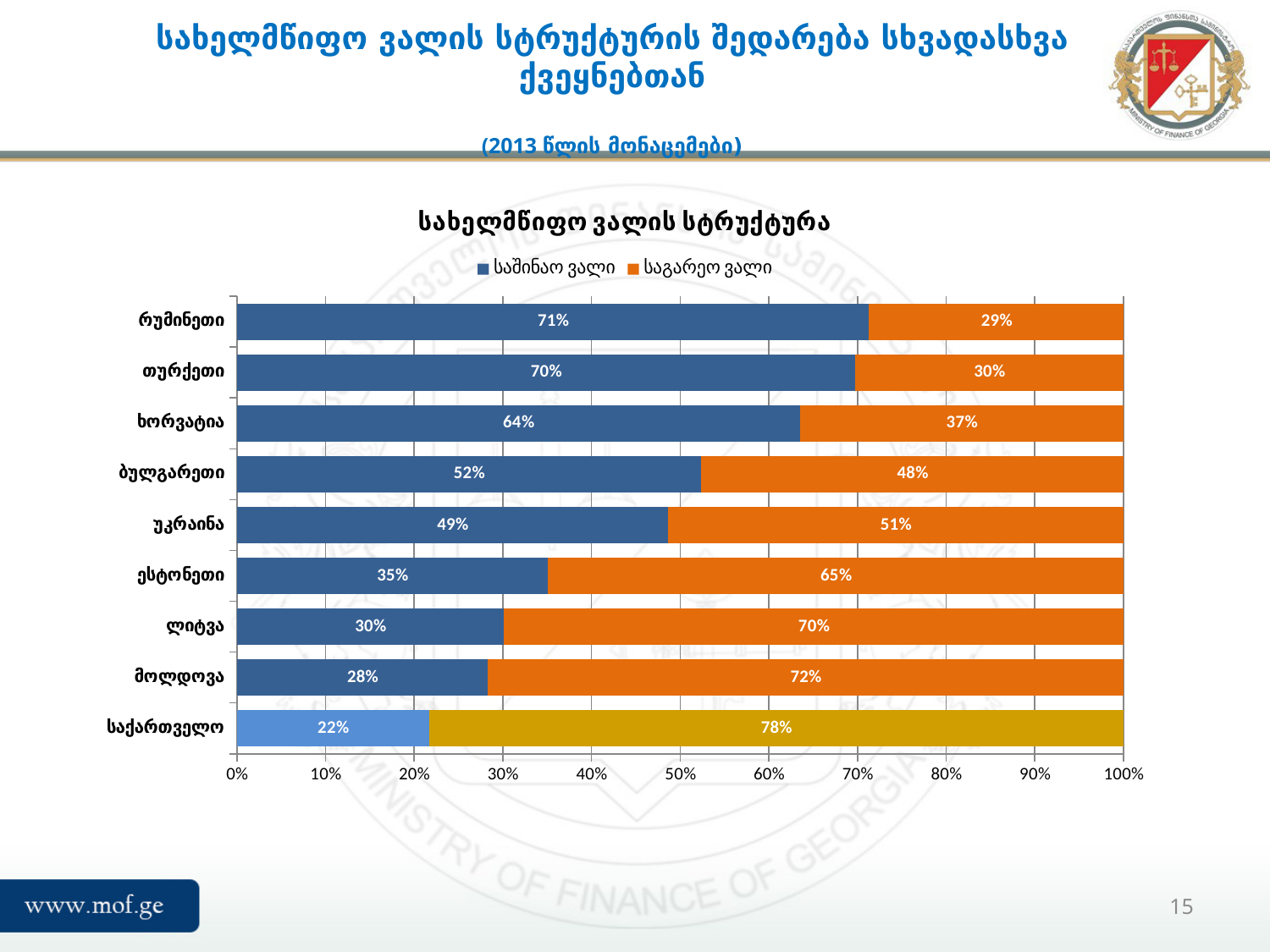
What is the value of საშინაო ვალი for რუმინეთი? 71% Which category has the highest value of საშინაო ვალი? რუმინეთი What is the value of საშინაო ვალი for უკრაინა? 49% Which is larger: the საშინაო ვალი value for ბულგარეთი or for ესტონეთი? ბულგარეთი How many categories are shown on the chart? 9 What is the value of საგარეო ვალი for ხორვატია? 37% How many series does the legend list? 2 Which category has the lowest value of საშინაო ვალი? საქართველო What is the title of the chart? სახელმწიფო ვალის სტრუქტურა What is the value of საგარეო ვალი for საქართველო? 78% What is the difference between the საგარეო ვალი values for მოლდოვა and ლიტვა? 2% What kind of chart is shown on the slide? Stacked bar chart